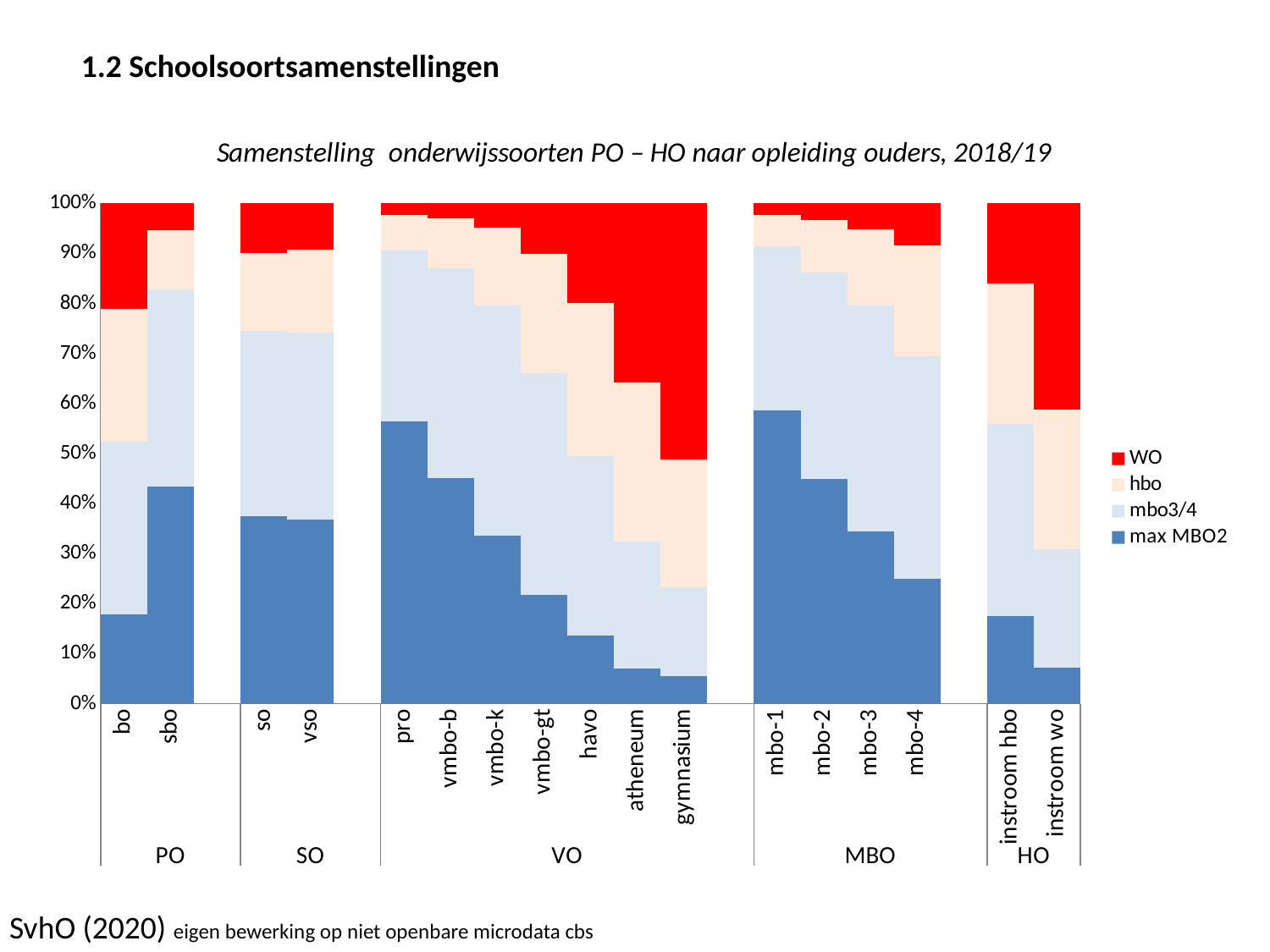
Within the MBO group, which category has the largest max MBO2 segment? mbo-1 Is the max MBO2 share for gymnasium greater or less than 10%? less How many series does the legend list? 4 What kind of chart is shown on the slide? stacked bar chart Which colour represents the WO series in the legend? red What is the title of the chart? Samenstelling onderwijssoorten PO – HO naar opleiding ouders, 2018/19 Within the VO group, does the max MBO2 share rise or fall from pro to gymnasium? fall Within the VO group, which category has the largest max MBO2 segment? pro Which has the larger max MBO2 share, mbo-1 or mbo-4? mbo-1 Which has the larger WO share, havo or gymnasium? gymnasium Is the max MBO2 share for pro greater or less than 50%? greater How many school-type categories are plotted along the x axis? 17